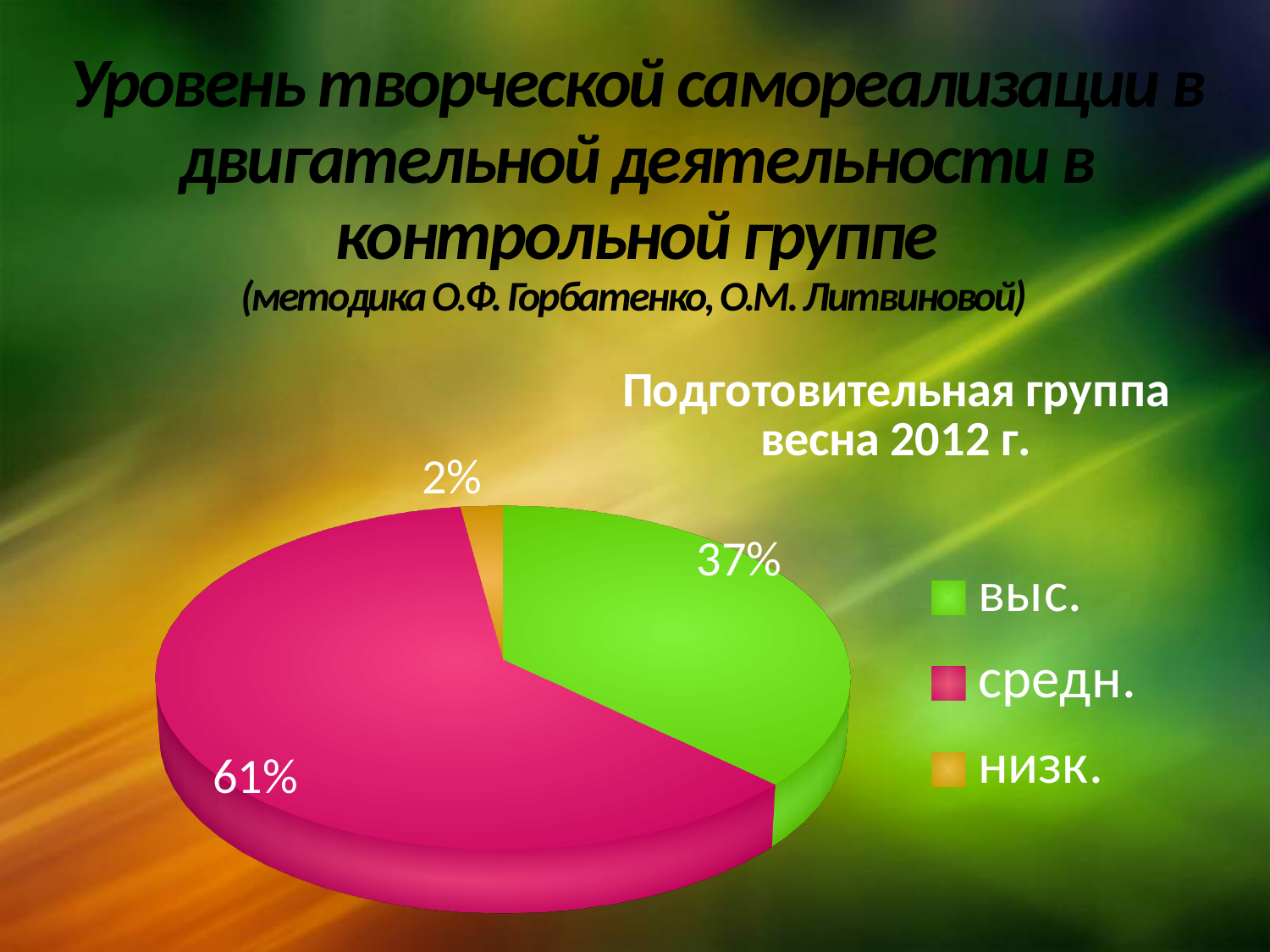
Which category has the largest slice of the pie? средн. What is the title of the chart? Подготовительная группа весна 2012 г. What kind of chart is shown on the slide? pie chart How many categories does the pie chart show? 3 What share of the pie does the "средн." slice represent? 61% What colour is the "средн." slice in the pie chart? pink What share of the pie does the "низк." slice represent? 2% Which slice is larger, "выс." or "низк."? выс. What is the difference in percentage points between the "средн." and "выс." slices? 24 Which category has the smallest slice of the pie? низк. What share of the pie does the "выс." slice represent? 37%